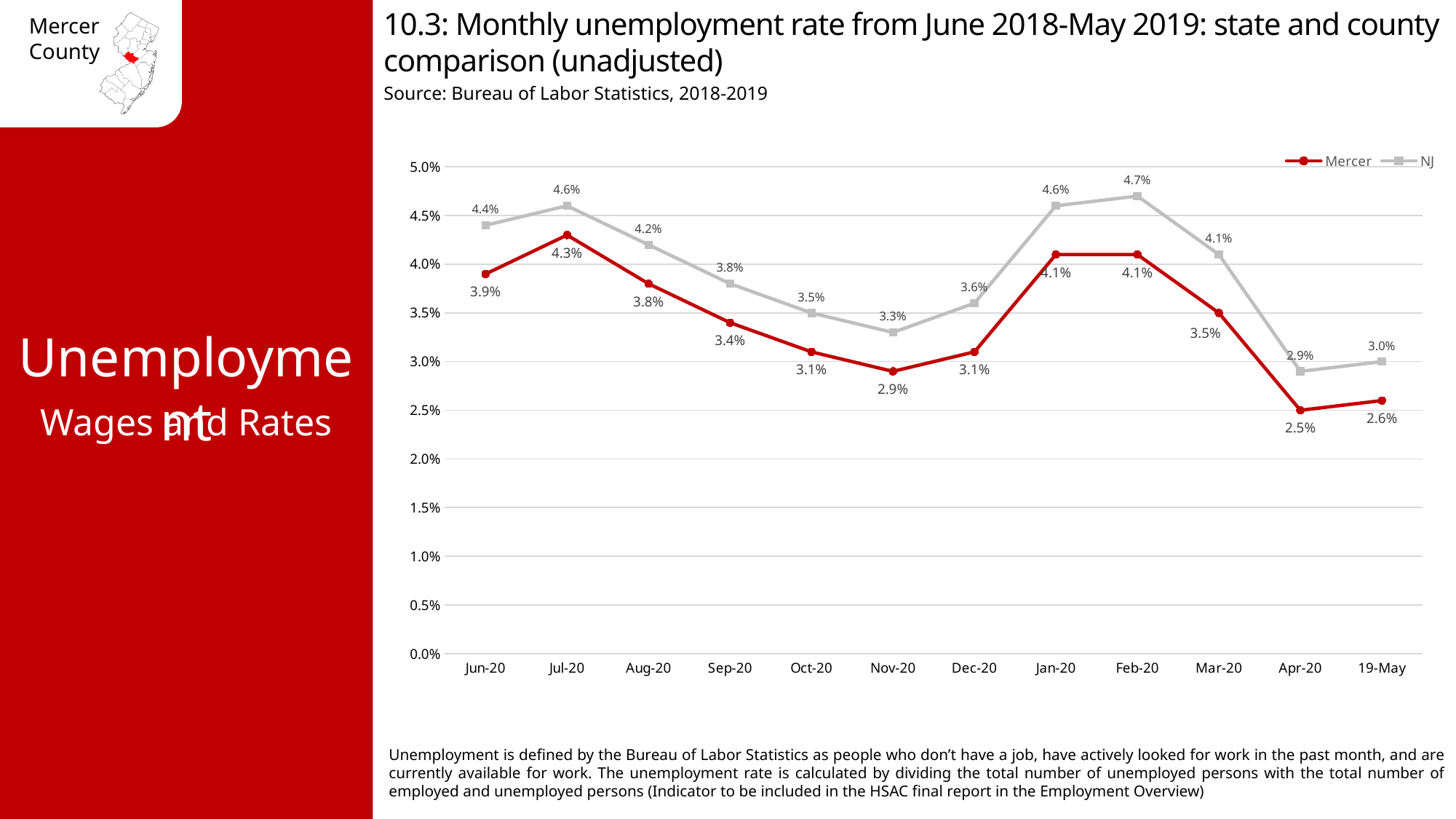
How many months are plotted on the x axis? 12 What is the Mercer unemployment rate for Jul-20? 4.3% In which month is the Mercer unemployment rate lowest? Apr-20 How many series does the legend list? 2 Is the Mercer value for Apr-20 greater or less than 3.0%? less What is the difference between the NJ and Mercer rates in Jul-20? 0.3 percentage points In which month does the NJ series reach its highest value? Feb-20 Which series has the higher value in Jan-20, Mercer or NJ? NJ What is the difference between the Mercer rates in Feb-20 and Mar-20? 0.6 percentage points What kind of chart is shown on the slide? Line chart What is the NJ unemployment rate for Nov-20? 3.3% What is the Mercer unemployment rate for 19-May? 2.6%